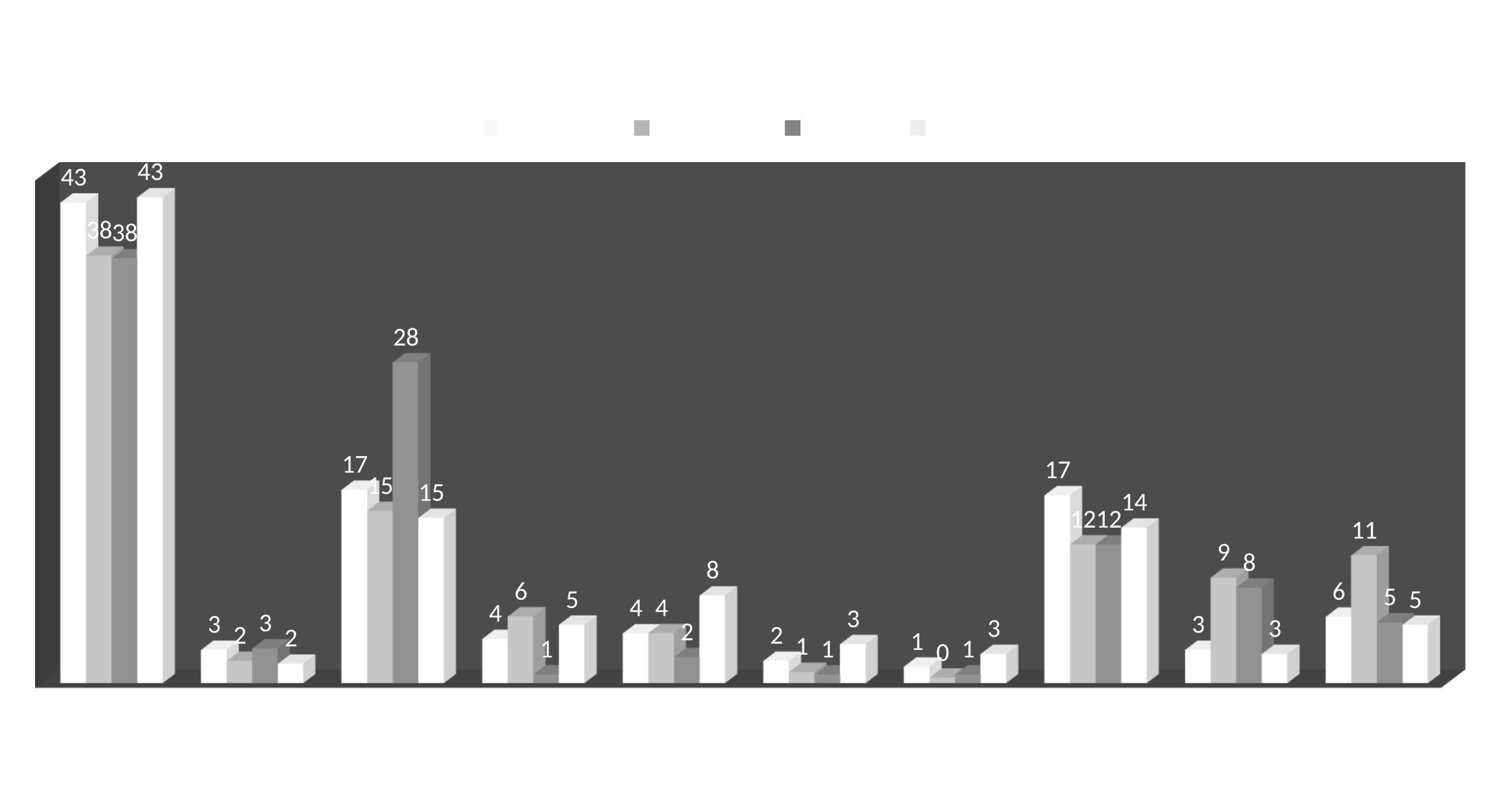
How many groups of bars are plotted along the x axis? 10 What is the value of the tallest bar in the seventh group from the left? 3 How many series does the legend show? 4 What is the value of the tallest bar in the second group from the left? 3 What is the highest value labelled on the chart? 43 What kind of chart is shown on the slide? bar chart In the leftmost group, what is the difference between the first bar (43) and the second bar (38)? 5 What is the lowest value labelled on the chart? 0 How many bars are in each group? 4 What is the value of the tallest bar in the rightmost group? 11